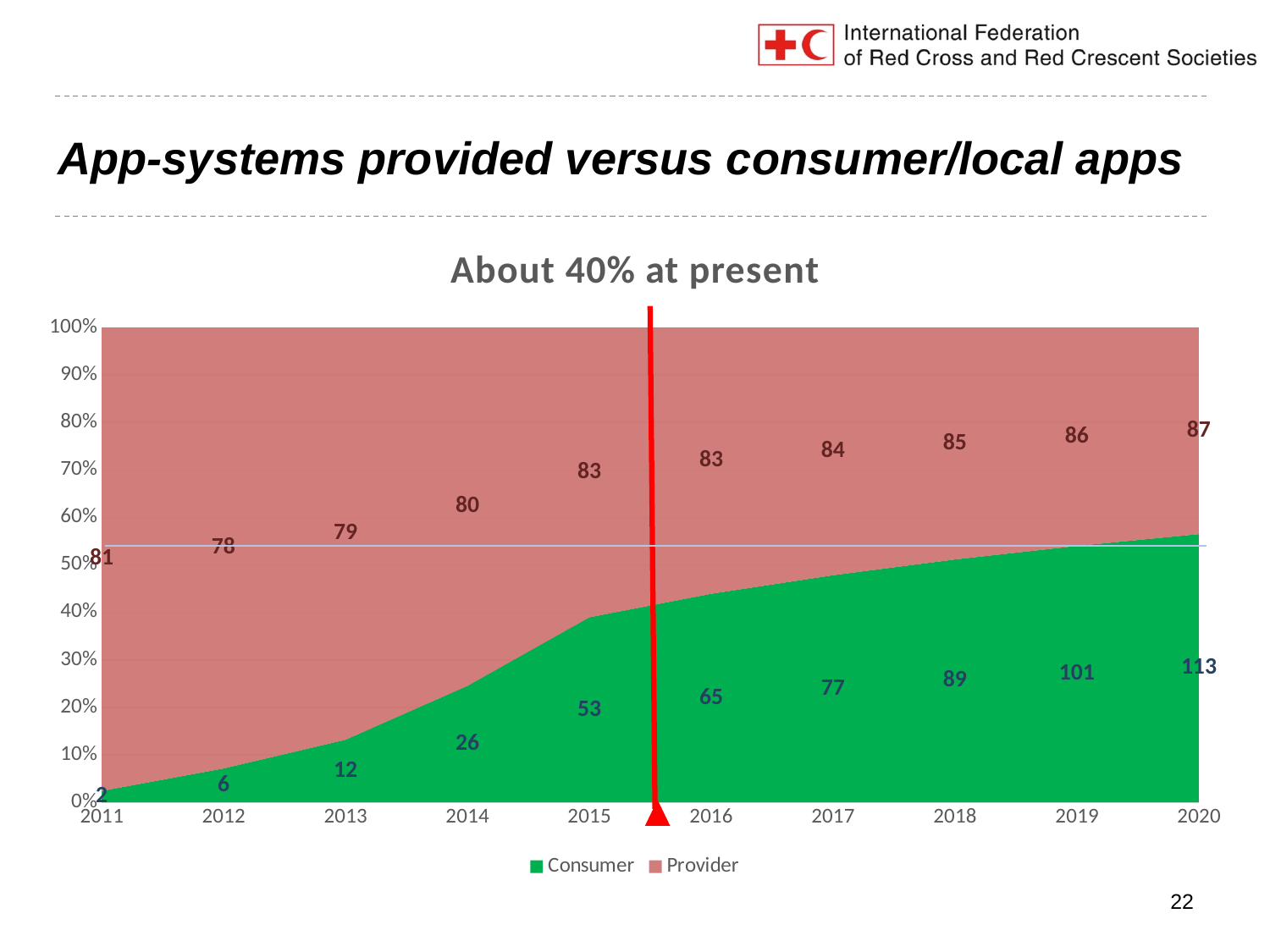
In which year is the Consumer value highest? 2020 Which is larger, the Consumer value for 2017 or the Provider value for 2017? Provider How many series does the legend list? 2 What kind of chart is shown? Area chart What is the Provider value for 2018? 85 What is the difference between the Provider values for 2020 and 2011? 6 What is the Consumer value for 2015? 53 What is the difference between the Consumer values for 2020 and 2019? 12 Does the Consumer value rise or fall from 2011 to 2020? Rise How many years are shown on the x axis? 10 In which year is the Provider value lowest? 2012 Is the Consumer share in 2020 greater or less than 50%? greater